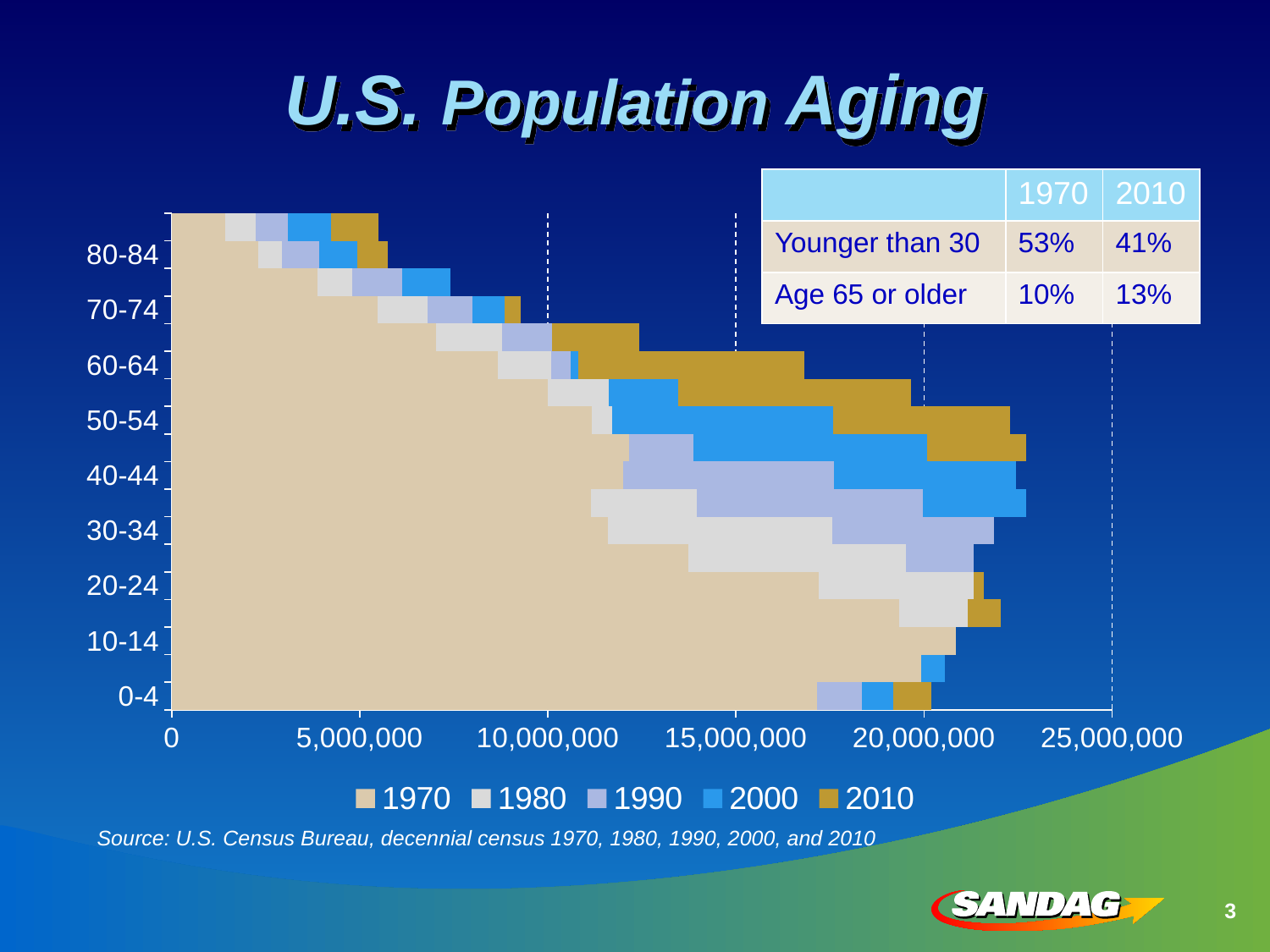
Do the 1970 values rise or fall as the age groups get older? fall What kind of chart is shown on the slide? bar chart Is the 2000 value for the 40-44 age group greater or less than 20,000,000? greater Is the 2010 value for the 50-54 age group greater or less than 20,000,000? greater Is the 1970 value for the 80-84 age group greater or less than 5,000,000? less For the 1970 series, which is larger: the value for 0-4 or the value for 60-64? 0-4 What is the title of the slide's chart? U.S. Population Aging What are the series listed in the chart legend? 1970, 1980, 1990, 2000, 2010 For the 50-54 age group, which is larger: the 1970 value or the 2010 value? 2010 How many series does the chart legend list? 5